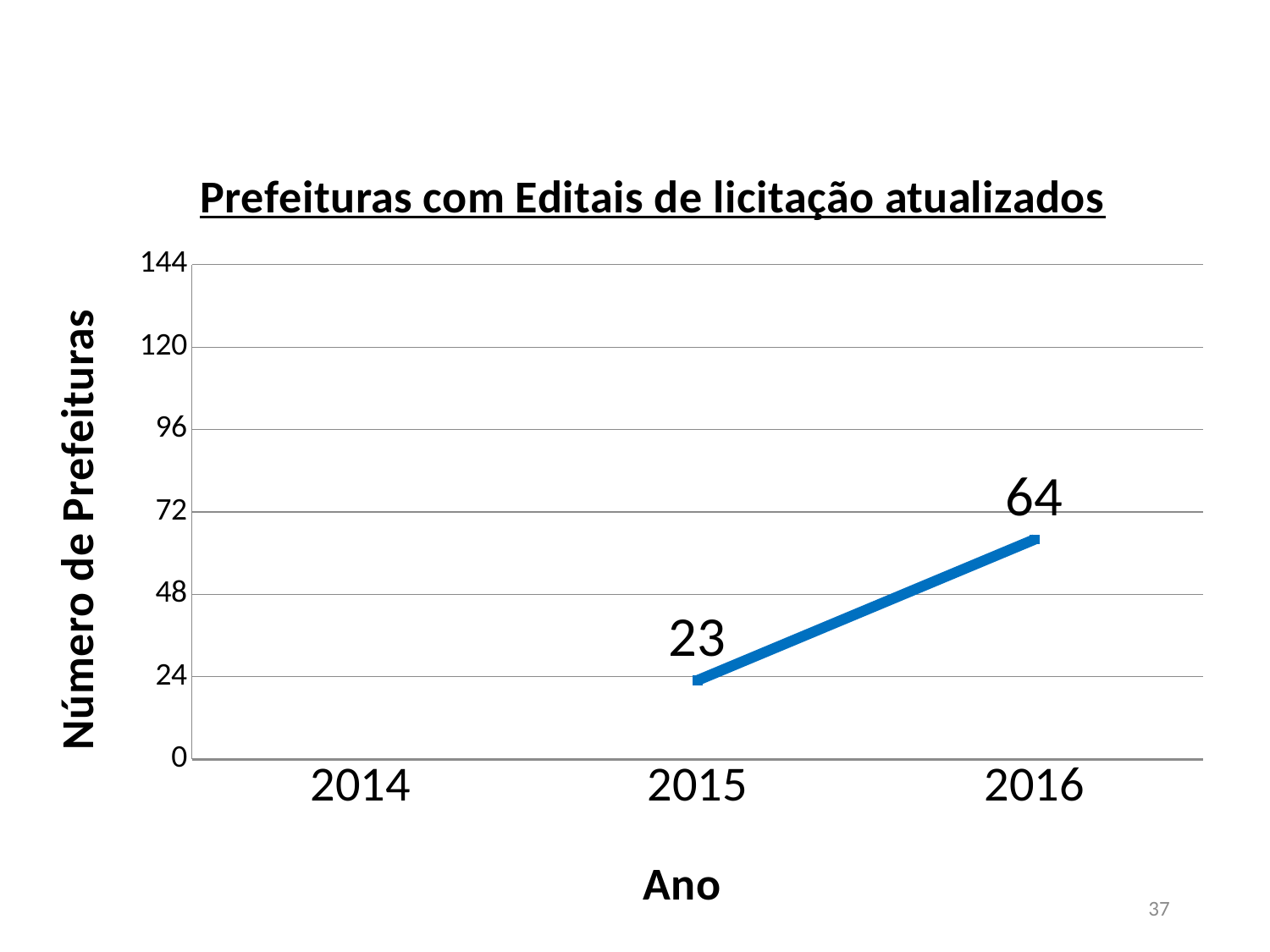
What is the difference between the values for 2016 and 2015? 41 Which year with a plotted value has the lowest value? 2015 What is the value for 2016? 64 Which year has the highest value? 2016 Is the value for 2015 greater or less than 48? less Do the values rise or fall from 2015 to 2016? rise What is the value for 2015? 23 How many years are labelled on the x axis? 3 What is the title of the chart? Prefeituras com Editais de licitação atualizados Is the value for 2016 greater or less than 48? greater Which is larger, the value for 2015 or the value for 2016? 2016 What kind of chart is shown? line chart